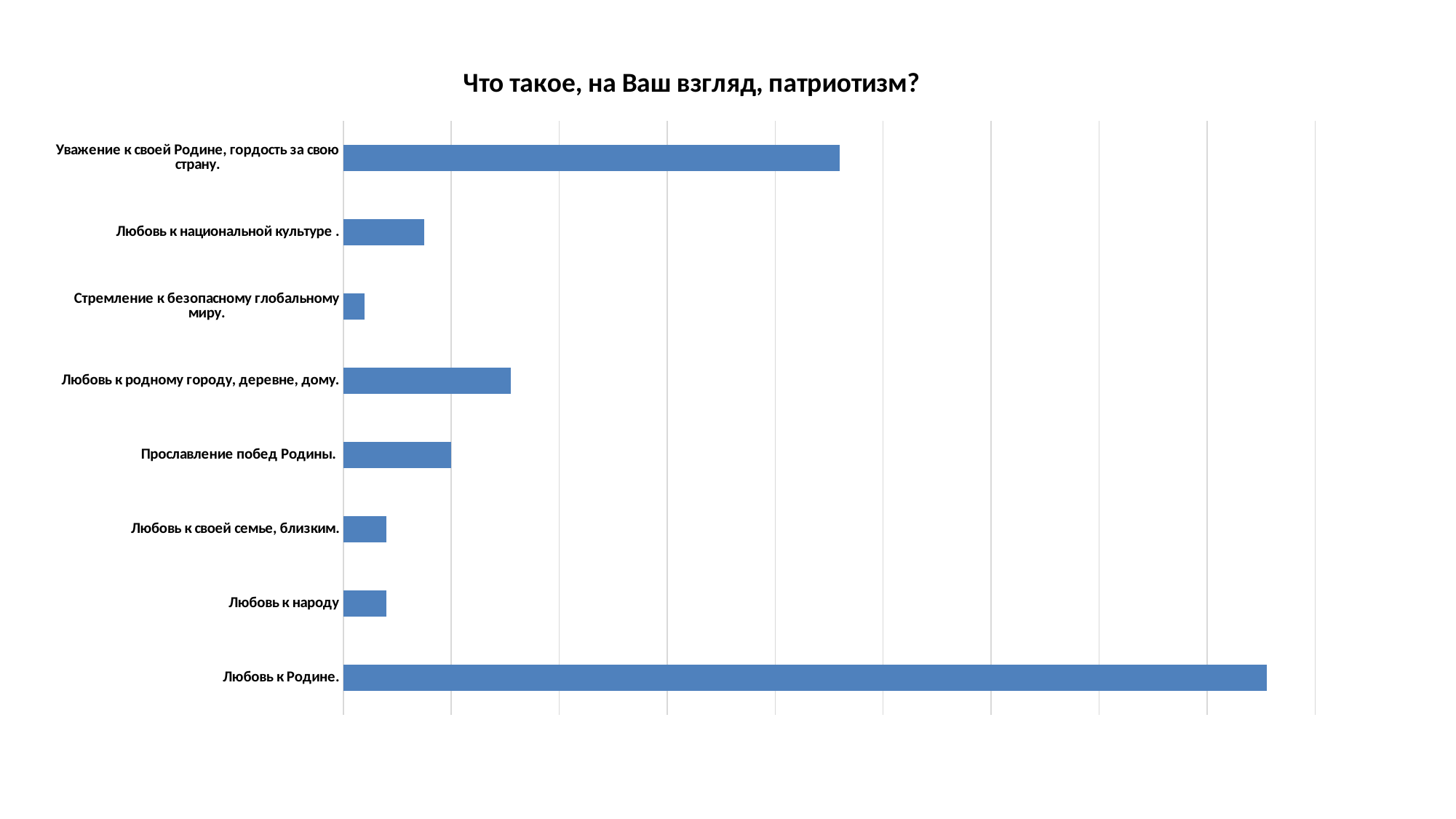
Which is larger: the value for "Любовь к Родине." or for "Уважение к своей Родине, гордость за свою страну."? Любовь к Родине. Which category has the second-longest bar? Уважение к своей Родине, гордость за свою страну. Which is larger: the value for "Уважение к своей Родине, гордость за свою страну." or for "Любовь к национальной культуре ."? Уважение к своей Родине, гордость за свою страну. What type of chart is shown on the slide? Bar chart What is the title of the chart? Что такое, на Ваш взгляд, патриотизм? How many categories are plotted in the chart? 8 Which is larger: the value for "Прославление побед Родины." or for "Любовь к народу"? Прославление побед Родины. Which category has the shortest bar? Стремление к безопасному глобальному миру. Which category has the longest bar? Любовь к Родине. Are the bars in the chart horizontal or vertical? Horizontal